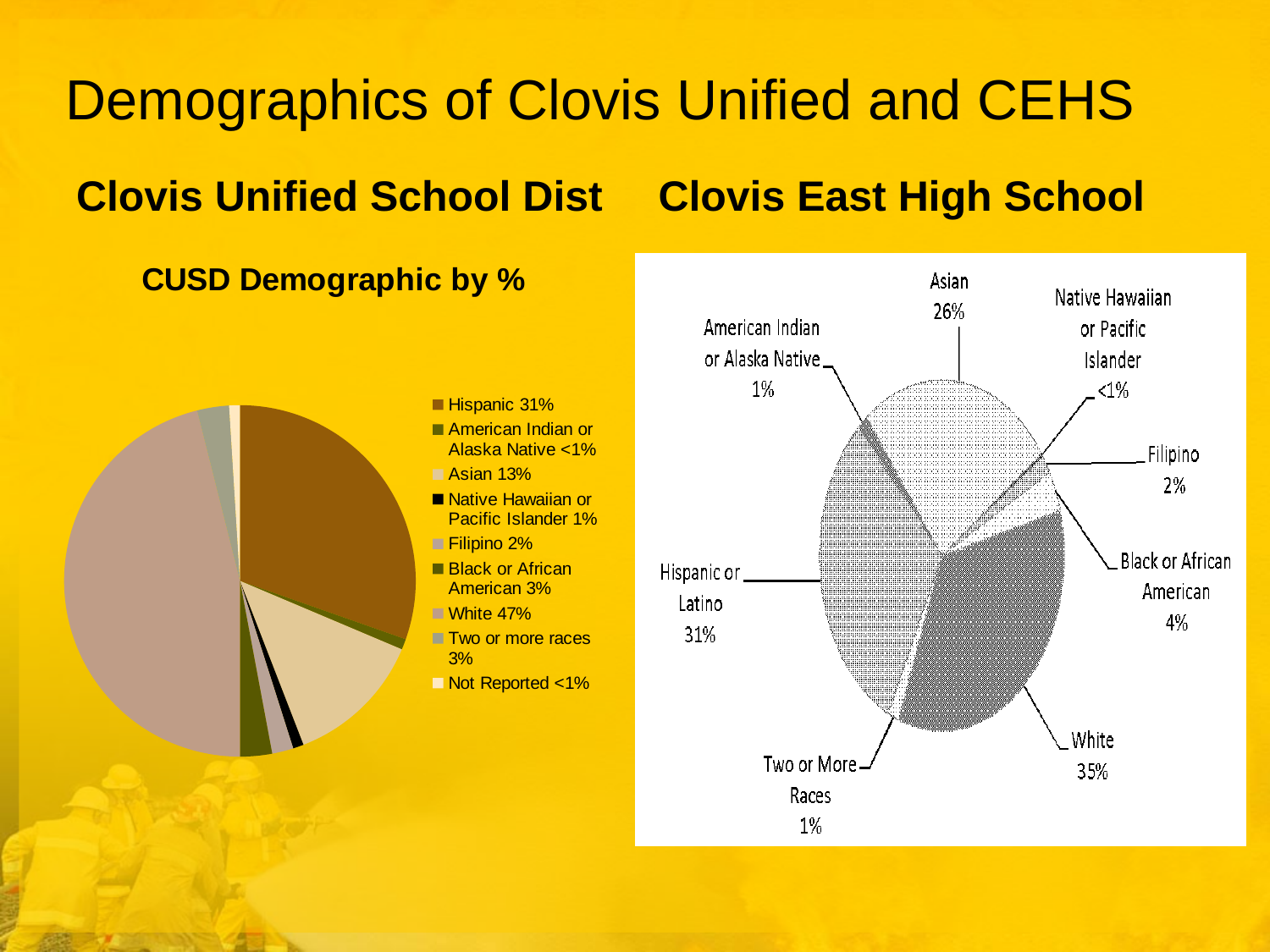
In the Clovis East High School pie chart, how many categories are labelled? 8 In the Clovis East High School pie chart, what is the difference between the White share and the Asian share? 9% In the Clovis East High School pie chart, which is larger, the White share or the Hispanic or Latino share? White What type of chart is used for the Clovis East High School demographics? Pie chart In the CUSD Demographic by % pie chart, what share is Asian? 13% In the CUSD Demographic by % pie chart, what share is White? 47% In the Clovis East High School pie chart, what share is Black or African American? 4% In the CUSD Demographic by % pie chart, what is the difference between the White share and the Hispanic share? 16% In the Clovis East High School pie chart, what share is Asian? 26% In the CUSD Demographic by % pie chart, which category has the largest share? White In the CUSD Demographic by % pie chart, how many categories does the legend list? 9 In the Clovis East High School pie chart, which category has the largest share? White